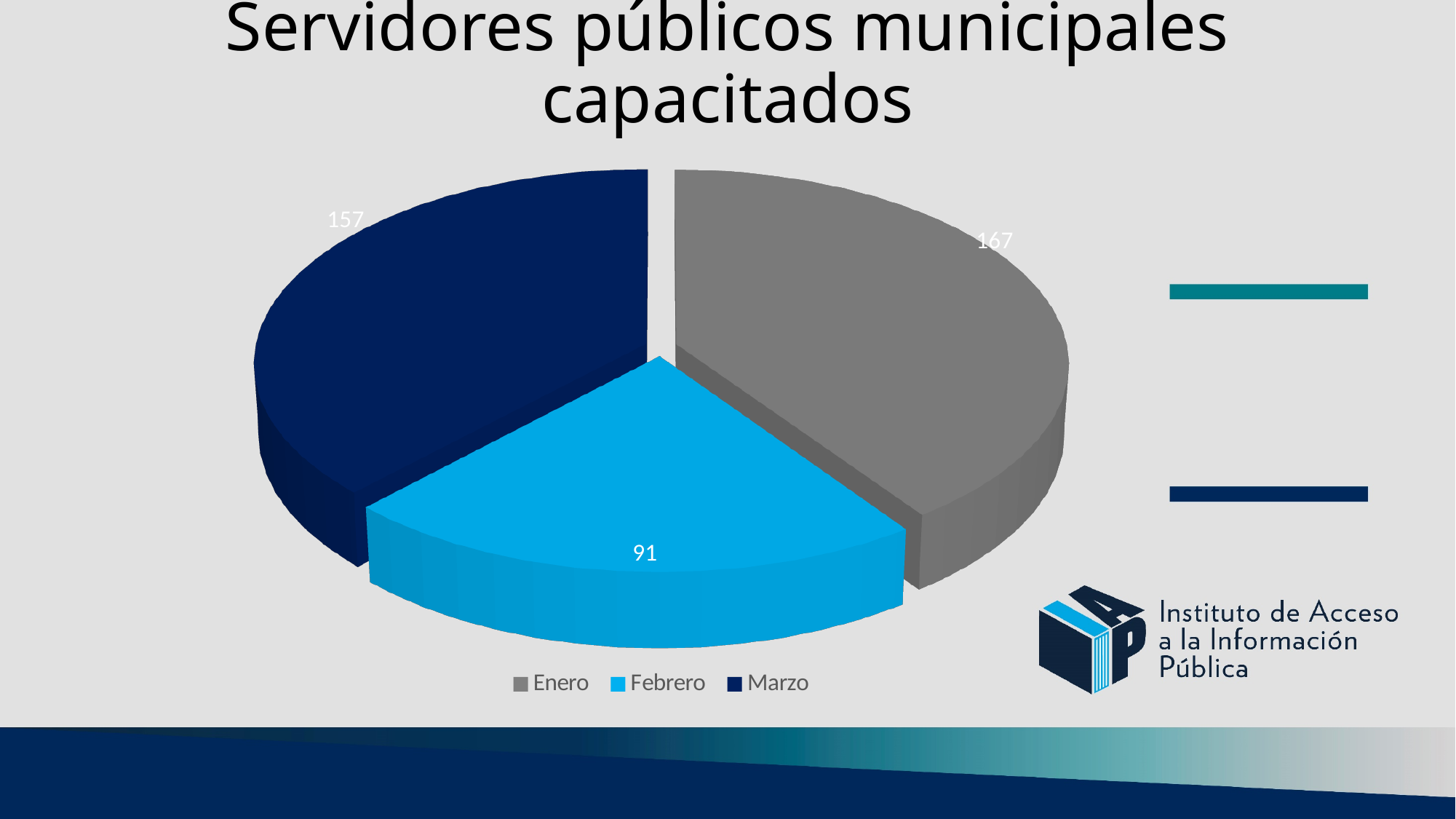
What is the value for Enero? 167 Which month has the lowest value? Febrero Which is larger, the value for Febrero or the value for Marzo? Marzo What type of chart is shown on the slide? pie chart What is the value for Febrero? 91 What is the difference between the values for Enero and Marzo? 10 What is the total of all three slices? 415 How many slices does the pie chart have? 3 Which month has the highest value? Enero What is the title of the chart? Servidores públicos municipales capacitados What is the difference between the values for Marzo and Febrero? 66 What is the value for Marzo? 157